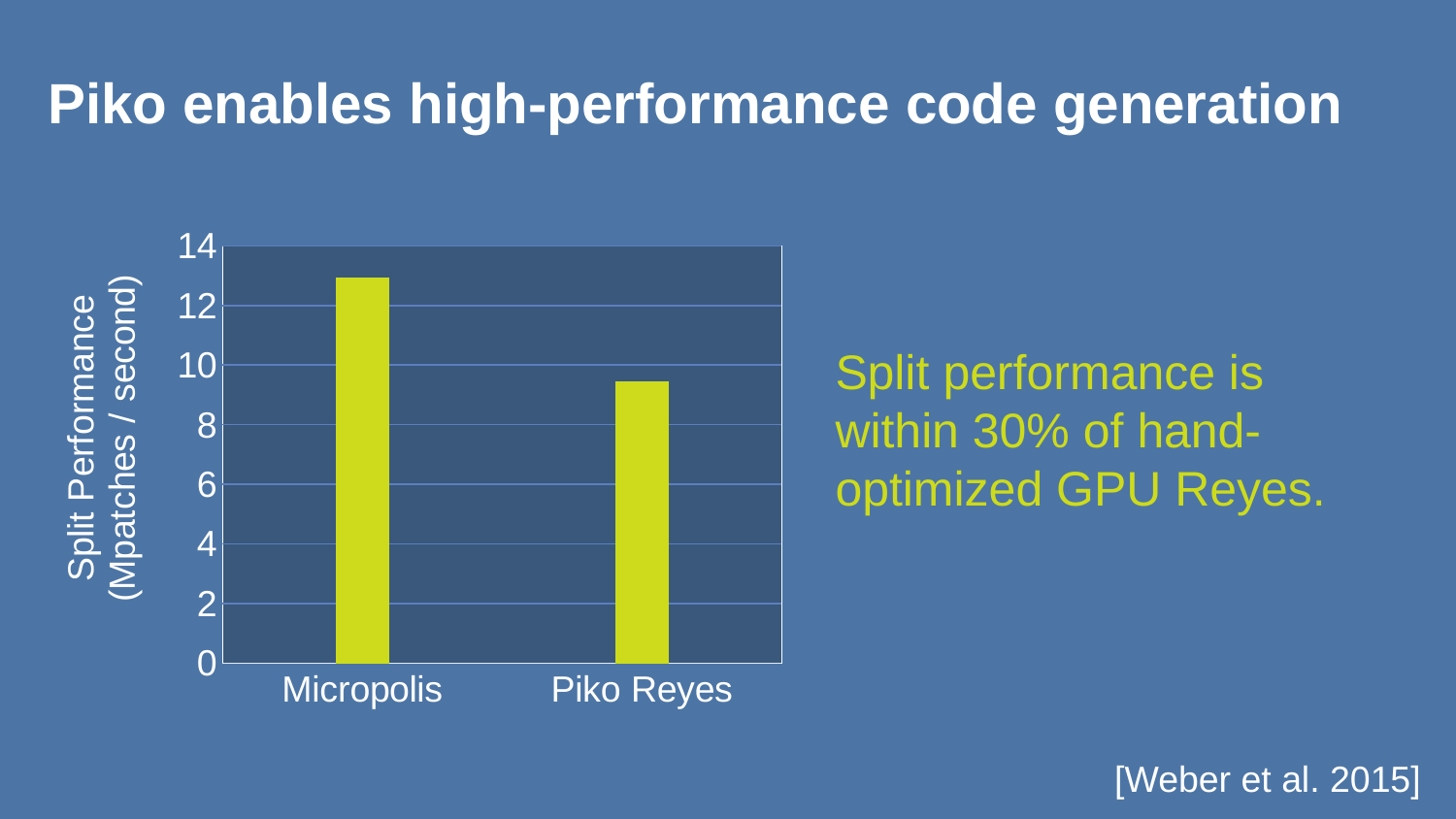
How many categories are plotted in the chart? 2 Is the value for Micropolis greater or less than 12? greater Which category has the highest split performance? Micropolis Is the value for Piko Reyes greater or less than 8? greater What is the maximum value shown on the y axis? 14 What kind of chart is shown on the slide? bar chart Is the value for Micropolis greater or less than 14? less Which has the larger split performance, Micropolis or Piko Reyes? Micropolis What is the label of the y axis? Split Performance (Mpatches / second) Which category has the lowest split performance? Piko Reyes